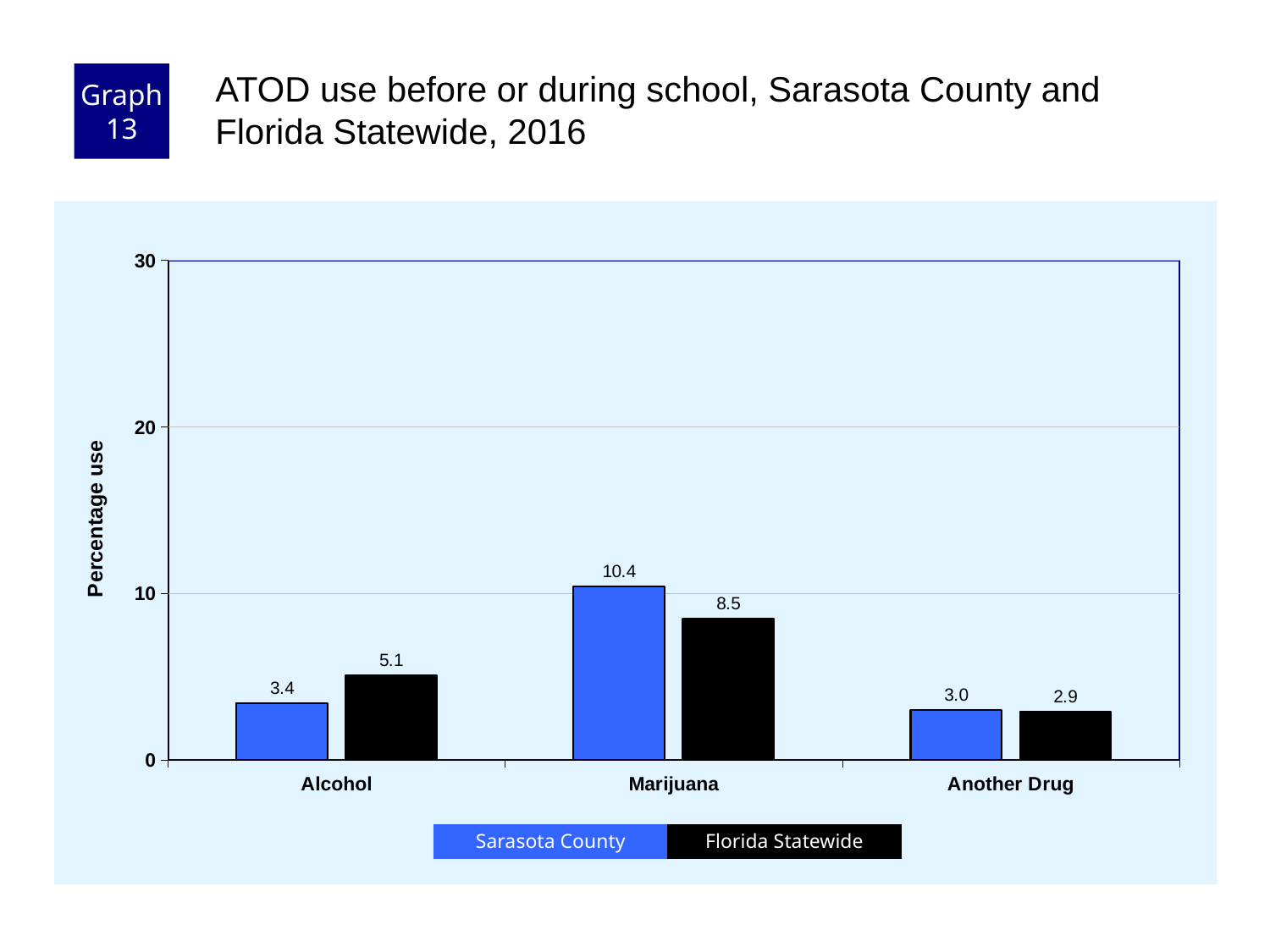
What is the difference between the Sarasota County and Florida Statewide values for Marijuana? 1.9 Which category has the lowest Florida Statewide value? Another Drug How many series does the legend list? 2 Is the Sarasota County value for Marijuana greater or less than 10? greater What kind of chart is shown on the slide? bar chart How many categories are shown on the x axis? 3 What is the Sarasota County value for Marijuana? 10.4 What is the difference between the Florida Statewide and Sarasota County values for Alcohol? 1.7 What is the Florida Statewide value for Alcohol? 5.1 Which is larger for Alcohol, the Sarasota County value or the Florida Statewide value? Florida Statewide Which category has the highest Sarasota County value? Marijuana What is the Florida Statewide value for Another Drug? 2.9